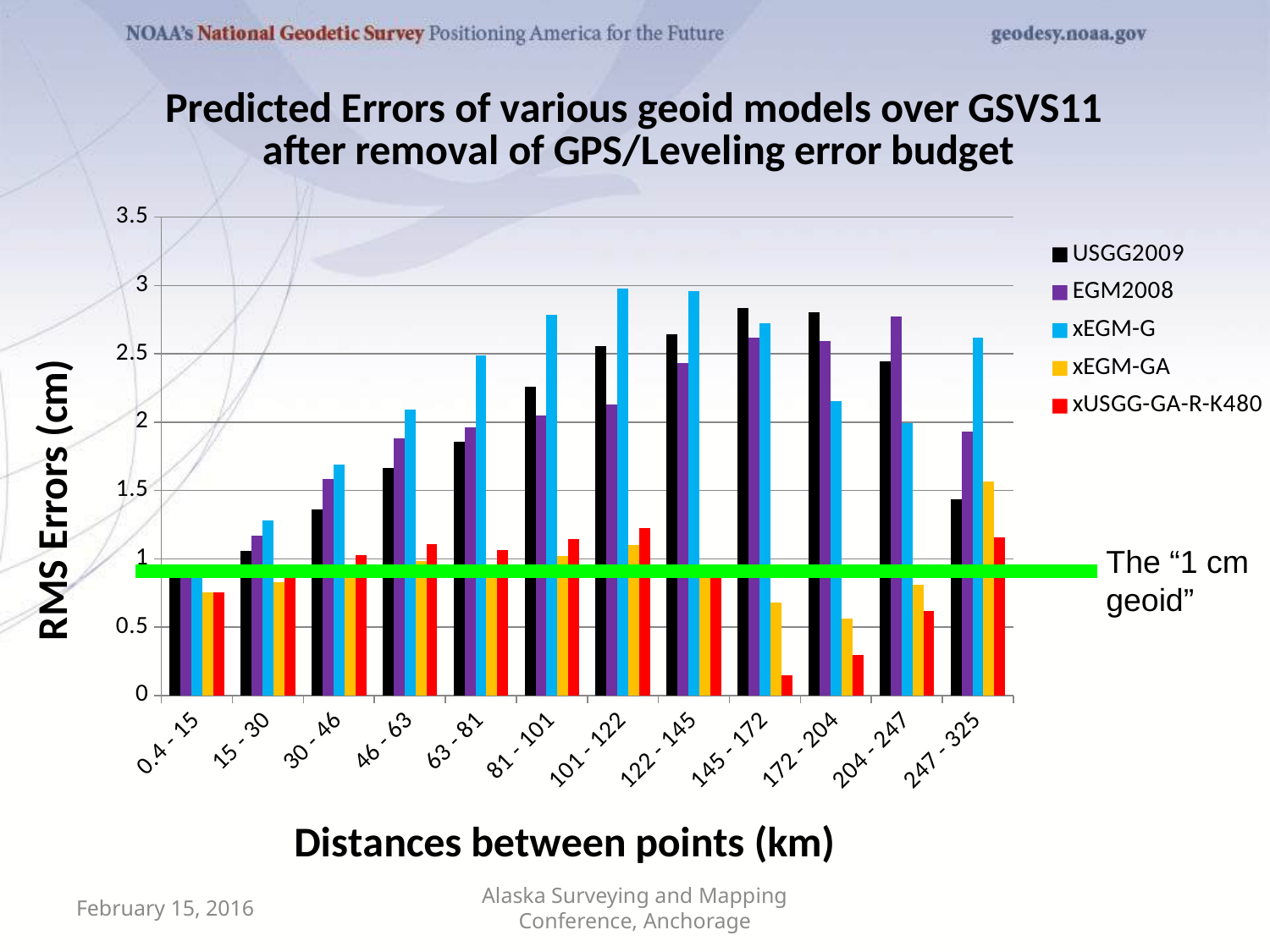
How many series does the legend list? 5 At 101 - 122 km, which is larger: xEGM-G or EGM2008? xEGM-G How many distance categories are shown on the x axis? 12 At 145 - 172 km, which is larger: USGG2009 or xEGM-GA? USGG2009 What kind of chart is shown on the slide? bar chart Is the value for xEGM-GA at 145 - 172 km greater or less than 1? less Is the value for xUSGG-GA-R-K480 at 172 - 204 km greater or less than 0.5? less Which series has the highest value at 101 - 122 km? xEGM-G Is the value for xEGM-G at 101 - 122 km greater or less than 2.5? greater What does the green horizontal line on the chart represent? The "1 cm geoid" Which series has the lowest value at 145 - 172 km? xUSGG-GA-R-K480